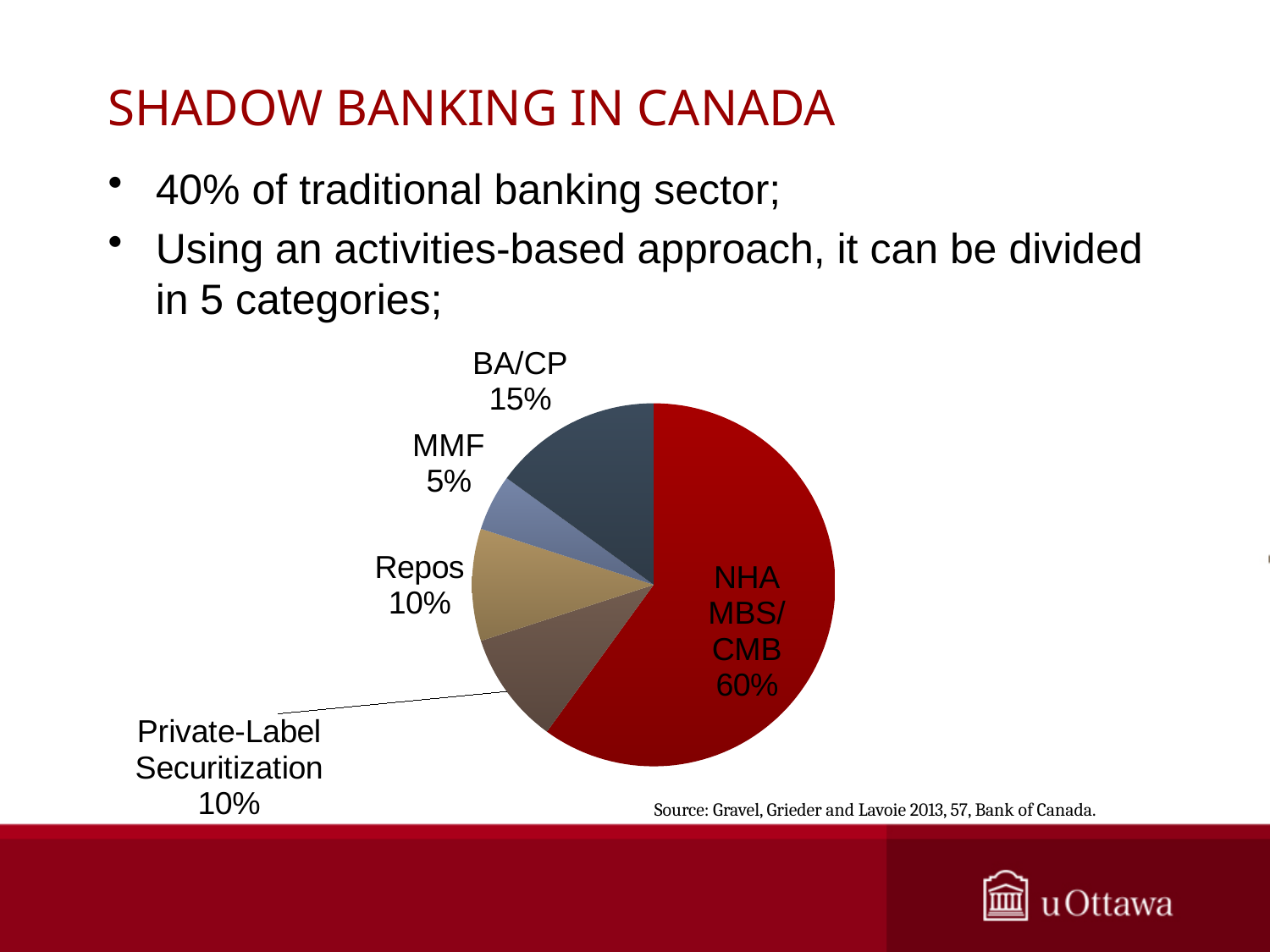
What is the difference in percentage points between NHA MBS/CMB and BA/CP? 45 What share of the pie does MMF hold? 5% Which category has the largest slice of the pie? NHA MBS/CMB What share of the pie does BA/CP hold? 15% What share of the pie does NHA MBS/CMB hold? 60% Which category has the smallest slice of the pie? MMF What share of the pie does Repos hold? 10% Which is larger, the share for BA/CP or the share for Repos? BA/CP How many categories are shown in the pie chart? 5 What colour is the NHA MBS/CMB slice? red What share of the pie does Private-Label Securitization hold? 10% What kind of chart is shown on the slide? pie chart